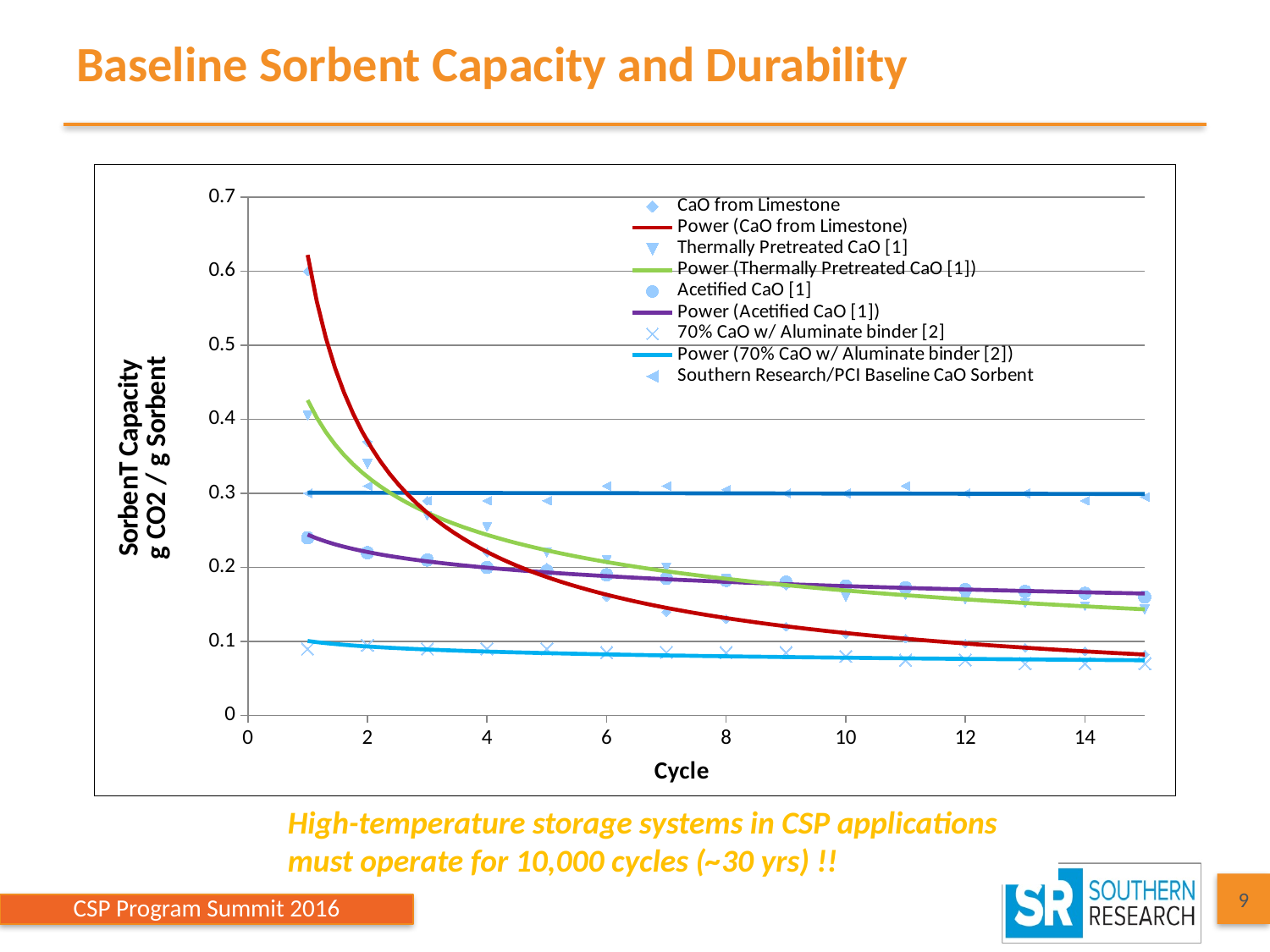
Is the value for Southern Research/PCI Baseline CaO Sorbent at cycle 8 greater or less than 0.2? greater At cycle 1, which is larger: CaO from Limestone or Acetified CaO [1]? CaO from Limestone What is the title of the x axis? Cycle Do the values for CaO from Limestone rise or fall as the cycle number increases? Fall At cycle 15, which is larger: Southern Research/PCI Baseline CaO Sorbent or 70% CaO w/ Aluminate binder [2]? Southern Research/PCI Baseline CaO Sorbent Is the value for Thermally Pretreated CaO [1] at cycle 1 greater or less than 0.3? greater Is the value for CaO from Limestone at cycle 1 greater or less than 0.5? greater How many entries does the chart legend list? 9 What kind of chart is shown on the slide? Scatter chart with trend lines What colour is the Power (CaO from Limestone) trend line? Red